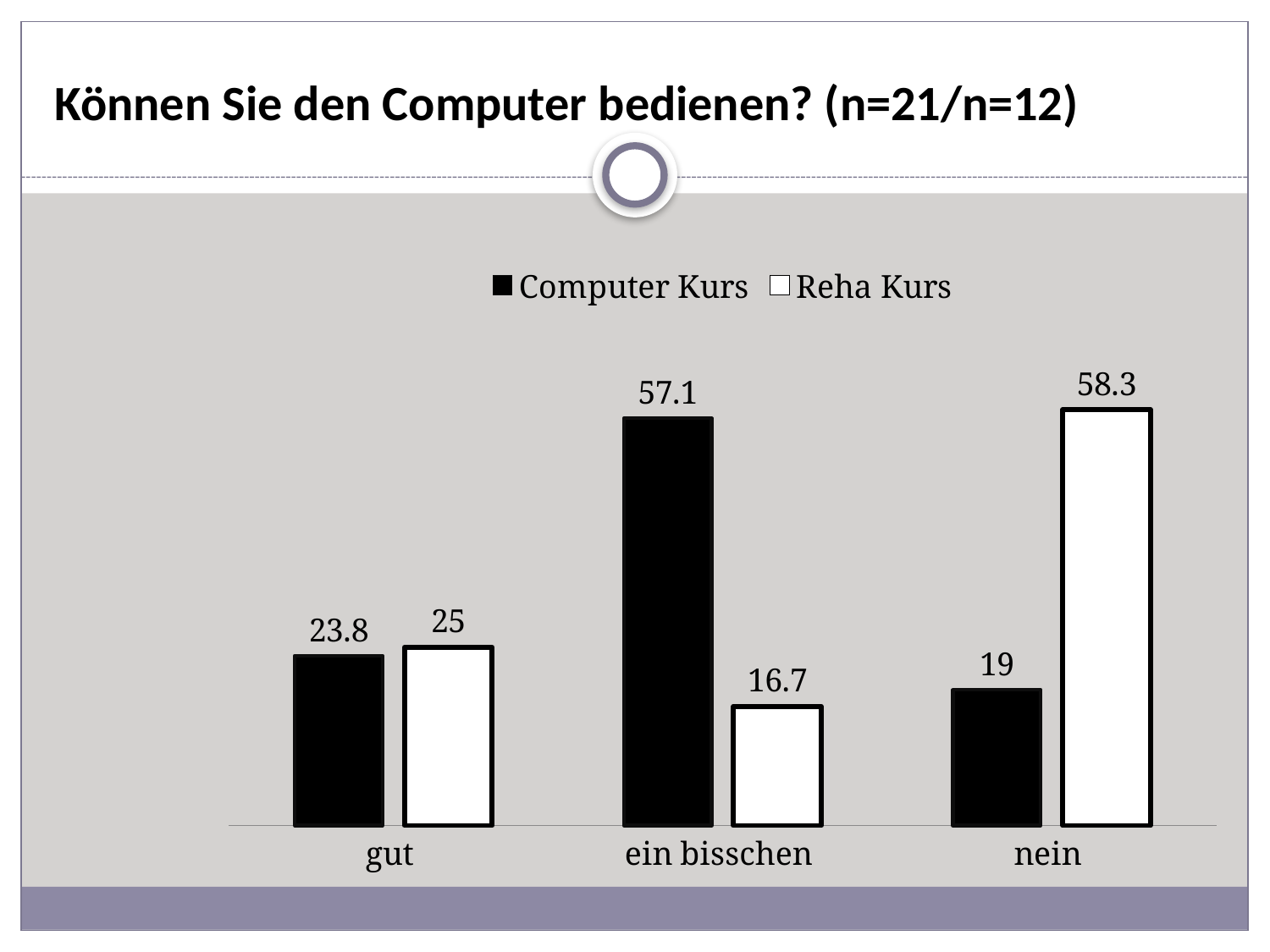
What is the value for Reha Kurs in the 'nein' category? 58.3 What is the title of the chart on the slide? Können Sie den Computer bedienen? (n=21/n=12) How many series does the legend list? 2 What is the value for Computer Kurs in the 'ein bisschen' category? 57.1 What is the difference between the Computer Kurs and Reha Kurs values in the 'ein bisschen' category? 40.4 Which category has the highest value for Computer Kurs? ein bisschen What is the value for Computer Kurs in the 'nein' category? 19 Which category has the lowest value for Reha Kurs? ein bisschen What kind of chart is shown on the slide? bar chart How many categories are shown on the x axis? 3 What is the value for Reha Kurs in the 'gut' category? 25 Which is larger in the 'nein' category: Computer Kurs or Reha Kurs? Reha Kurs